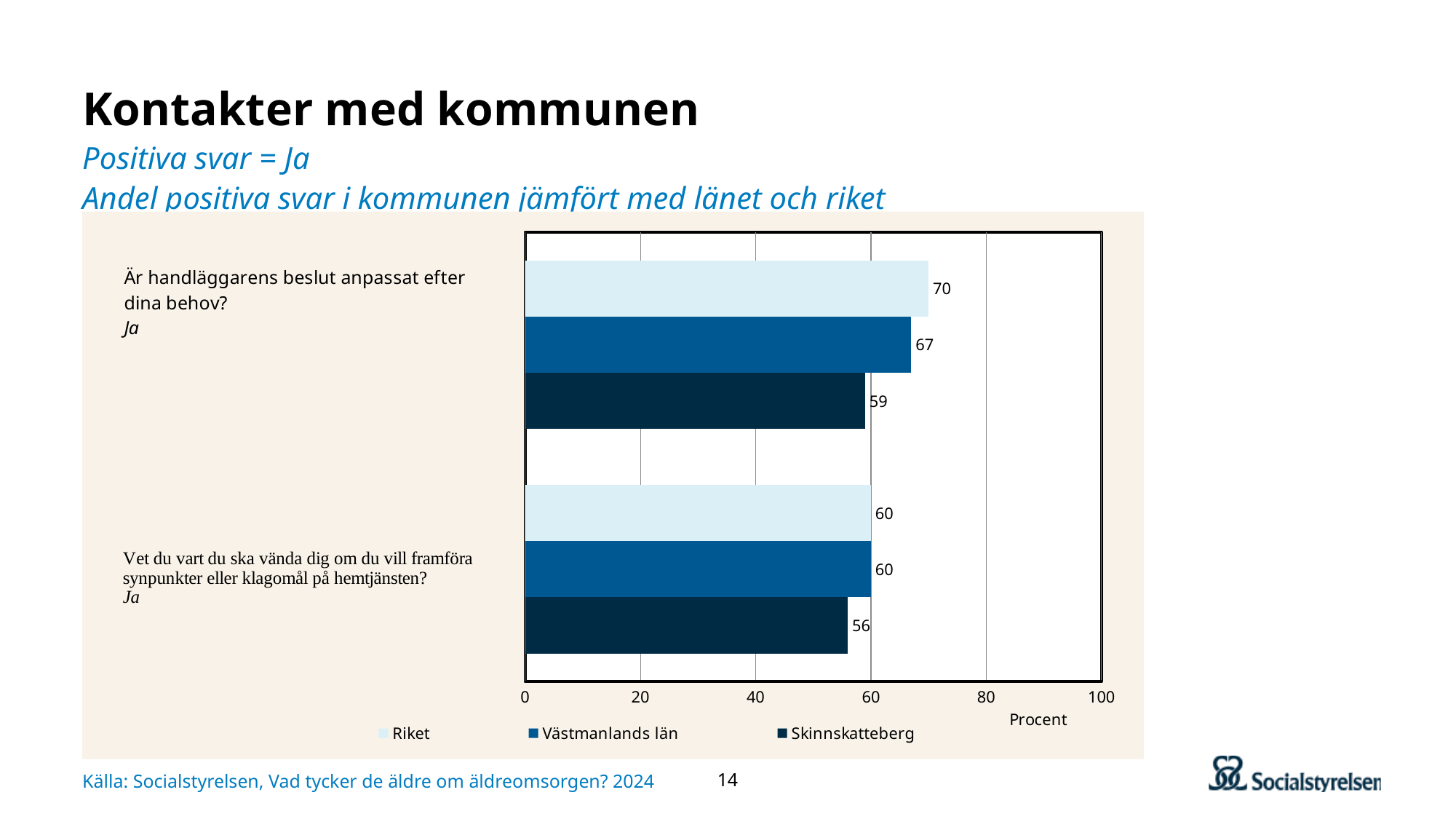
Which series has the highest value on the question "Är handläggarens beslut anpassat efter dina behov?"? Riket What is the value for Riket on the question "Vet du vart du ska vända dig om du vill framföra synpunkter eller klagomål på hemtjänsten?"? 60 What is the value for Västmanlands län on the question "Är handläggarens beslut anpassat efter dina behov?"? 67 How many series does the legend list? 3 What is the difference between Riket and Skinnskatteberg on the question "Är handläggarens beslut anpassat efter dina behov?"? 11 Which series has the lowest value on the question "Vet du vart du ska vända dig om du vill framföra synpunkter eller klagomål på hemtjänsten?"? Skinnskatteberg What is the value for Skinnskatteberg on the question "Är handläggarens beslut anpassat efter dina behov?"? 59 Is the value for Skinnskatteberg on "Är handläggarens beslut anpassat efter dina behov?" greater or less than 60? less What kind of chart is shown on the slide? Bar chart What is the value for Riket on the question "Är handläggarens beslut anpassat efter dina behov?"? 70 What is the value for Skinnskatteberg on the question "Vet du vart du ska vända dig om du vill framföra synpunkter eller klagomål på hemtjänsten?"? 56 What is the label on the x axis of the chart? Procent